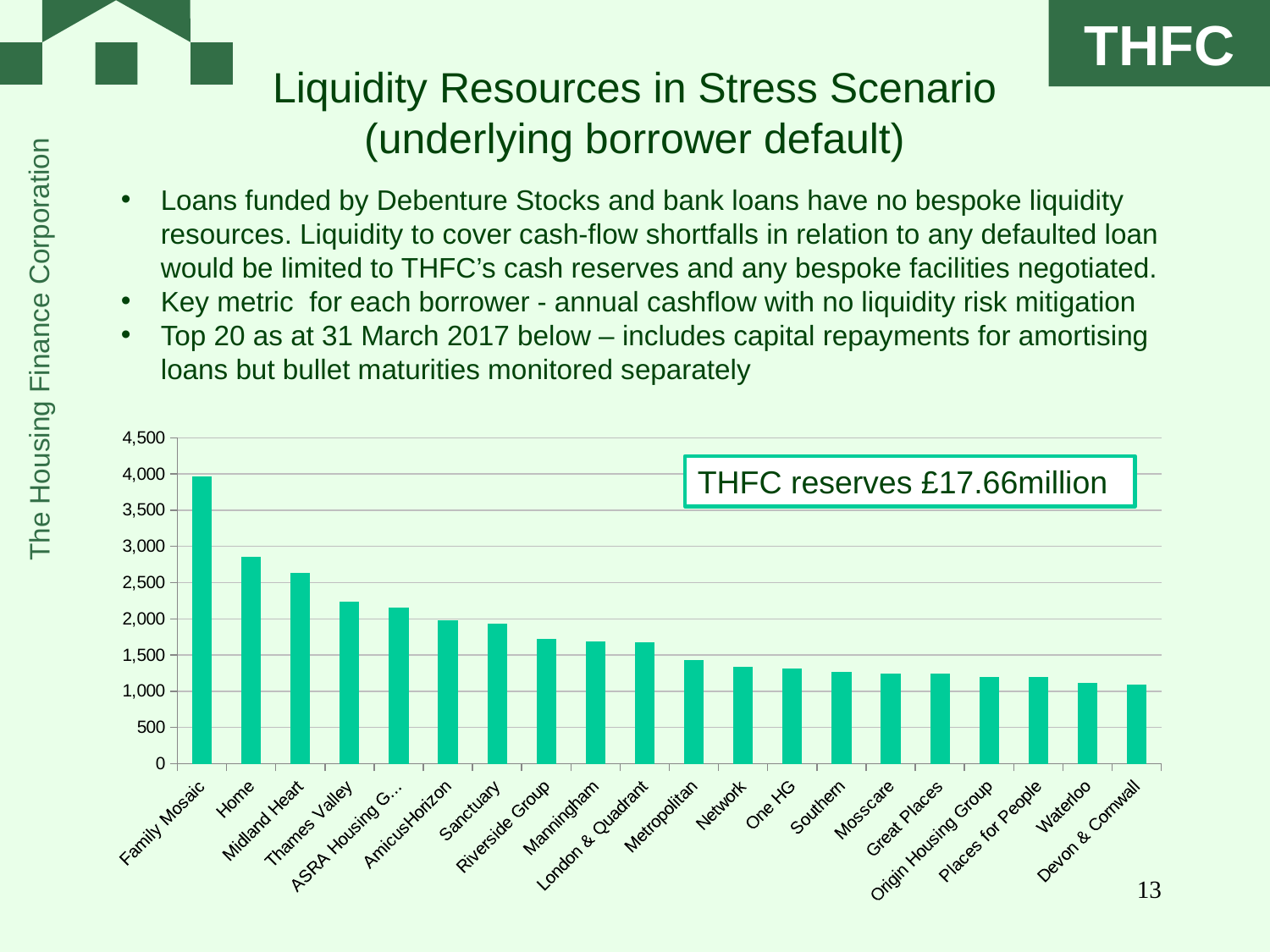
Which has the larger value, Home or Midland Heart? Home Is the value for Family Mosaic greater or less than 3,500? greater Is the value for Sanctuary greater or less than 2,000? less Which borrower has the lowest bar in the chart? Devon & Cornwall Do the bar values rise or fall moving from left to right along the x axis? fall What amount of THFC reserves is stated in the text box on the chart? £17.66million How many borrowers are shown on the x axis of the chart? 20 Which has the larger value, Thames Valley or Riverside Group? Thames Valley Is the value for Home greater or less than 2,500? greater What kind of chart is shown on the slide? bar chart Which borrower has the highest bar in the chart? Family Mosaic